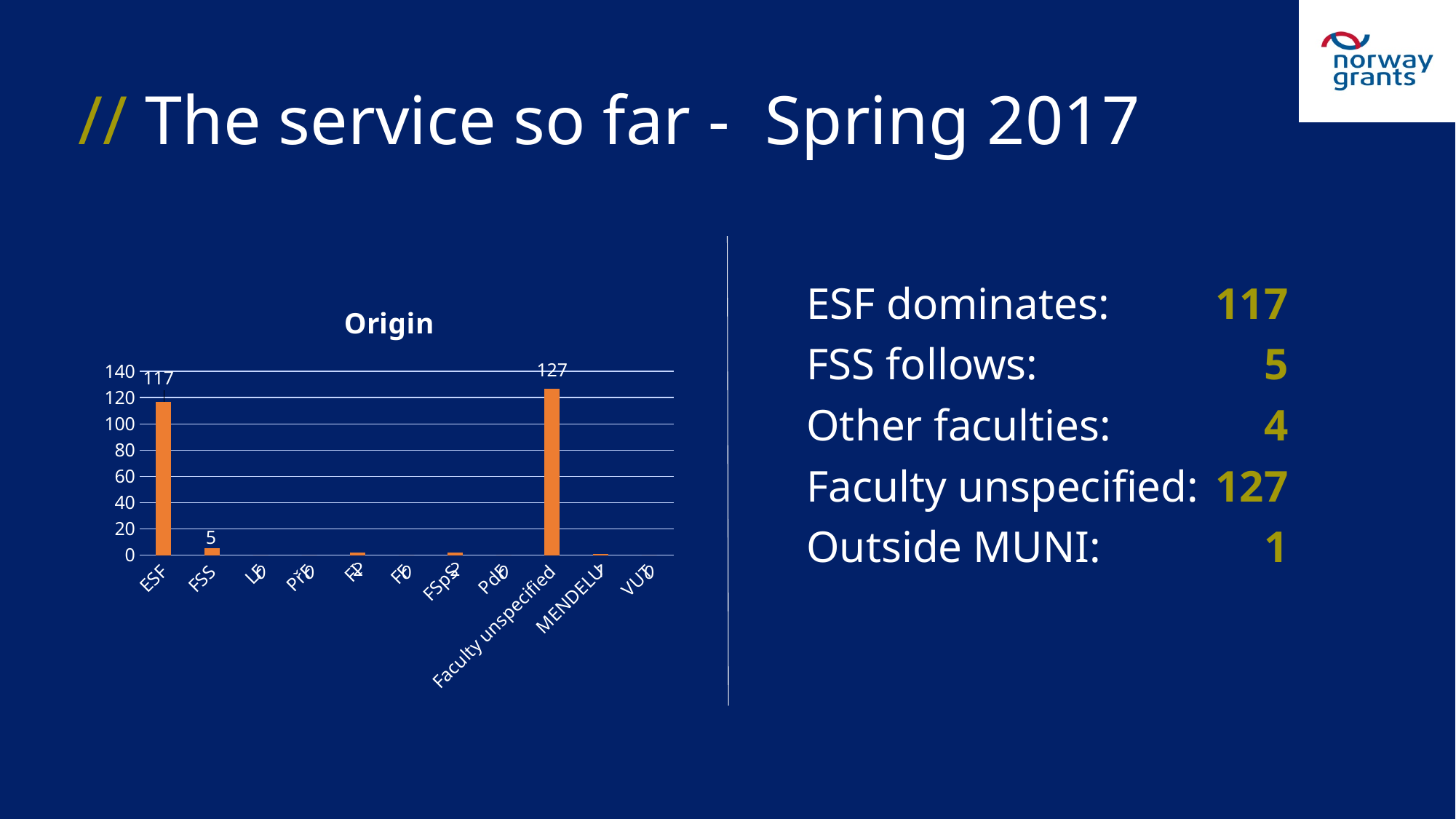
What kind of chart is the Origin chart? bar chart Is the value for FSS in the Origin chart greater or less than 20? less What is the title of the chart on the slide? Origin What is the value for ESF in the Origin chart? 117 Which is larger in the Origin chart, the value for ESF or the value for FSS? ESF What is the value for FSS in the Origin chart? 5 Is the value for ESF in the Origin chart greater or less than 100? greater Which category has the highest value in the Origin chart? Faculty unspecified What is the difference between the values for ESF and FSS in the Origin chart? 112 What is the value for Faculty unspecified in the Origin chart? 127 How many categories are shown on the x axis of the Origin chart? 11 What is the difference between the values for Faculty unspecified and ESF in the Origin chart? 10